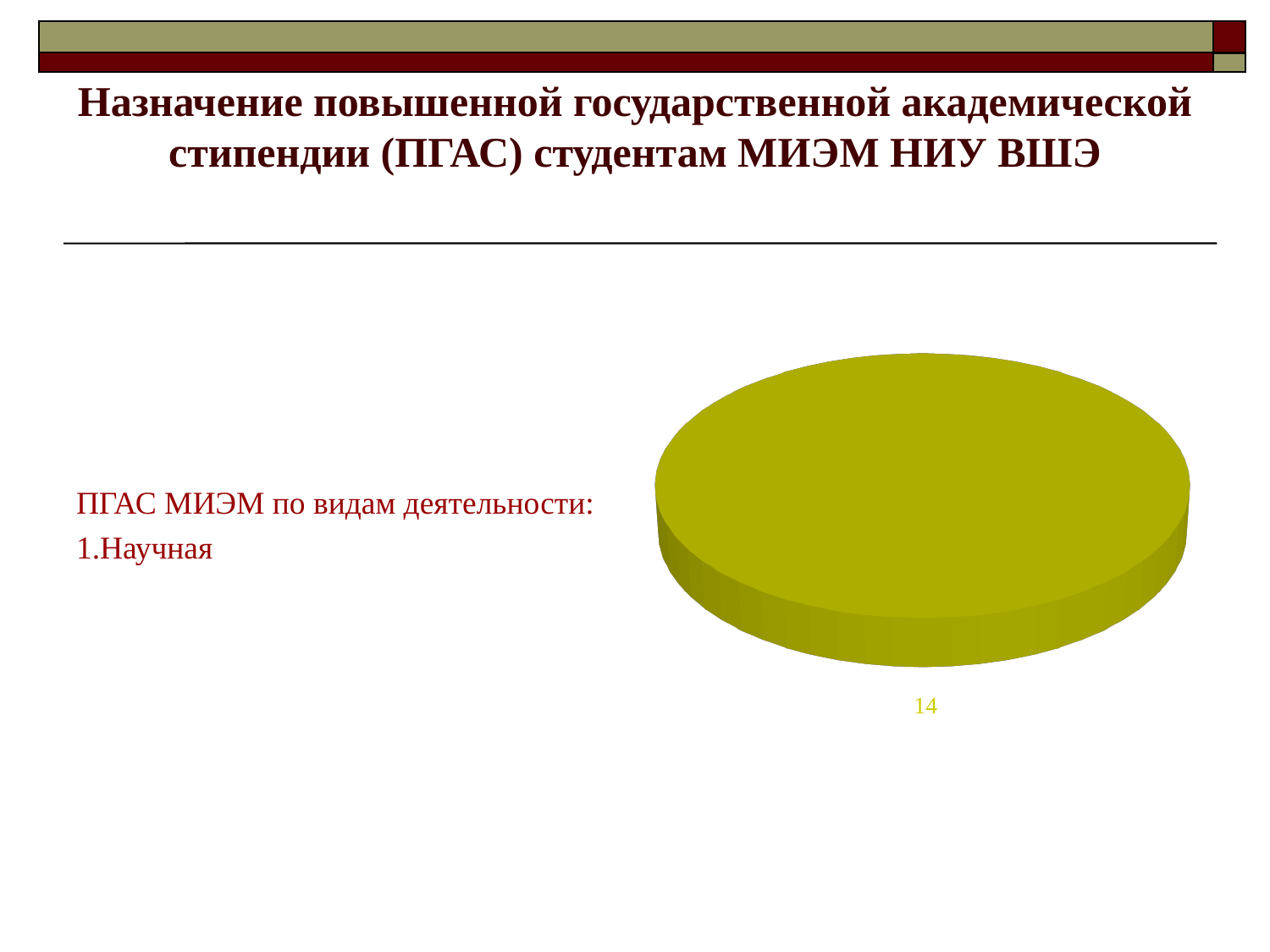
What colour is the slice of the pie chart? yellow-olive What share of the pie does the single slice labelled 14 represent? 100% Is the value shown on the pie chart greater or less than 10? greater How many slices does the pie chart have? 1 Is the pie chart drawn in 3D or flat? 3D What kind of chart is shown on the slide? pie chart What value is printed as the data label on the pie chart? 14